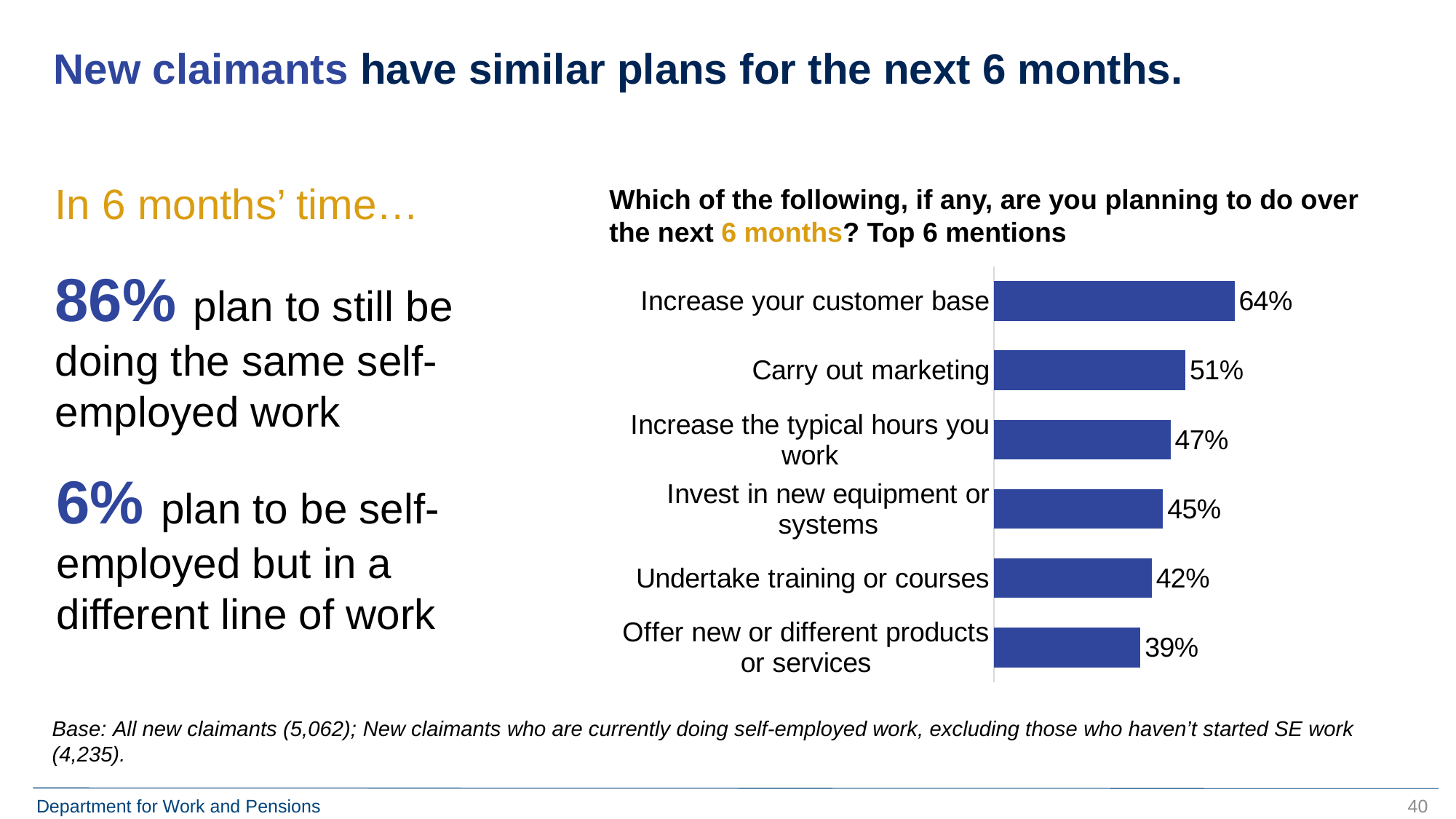
What is the difference in percentage points between 'Increase the typical hours you work' and 'Invest in new equipment or systems'? 2 What type of chart is used to show the planned activities? Bar chart How many planned activities are shown in the chart? 6 Which is larger: the value for 'Undertake training or courses' or the value for 'Offer new or different products or services'? Undertake training or courses What is the title of the chart? Which of the following, if any, are you planning to do over the next 6 months? Top 6 mentions What percentage of new claimants plan to increase their customer base over the next 6 months? 64% What is the value for 'Offer new or different products or services'? 39% What is the value shown for 'Carry out marketing'? 51% Which planned activity has the highest percentage in the chart? Increase your customer base What is the difference in percentage points between 'Increase your customer base' and 'Carry out marketing'? 13 Which planned activity has the lowest percentage in the chart? Offer new or different products or services What percentage plan to undertake training or courses? 42%